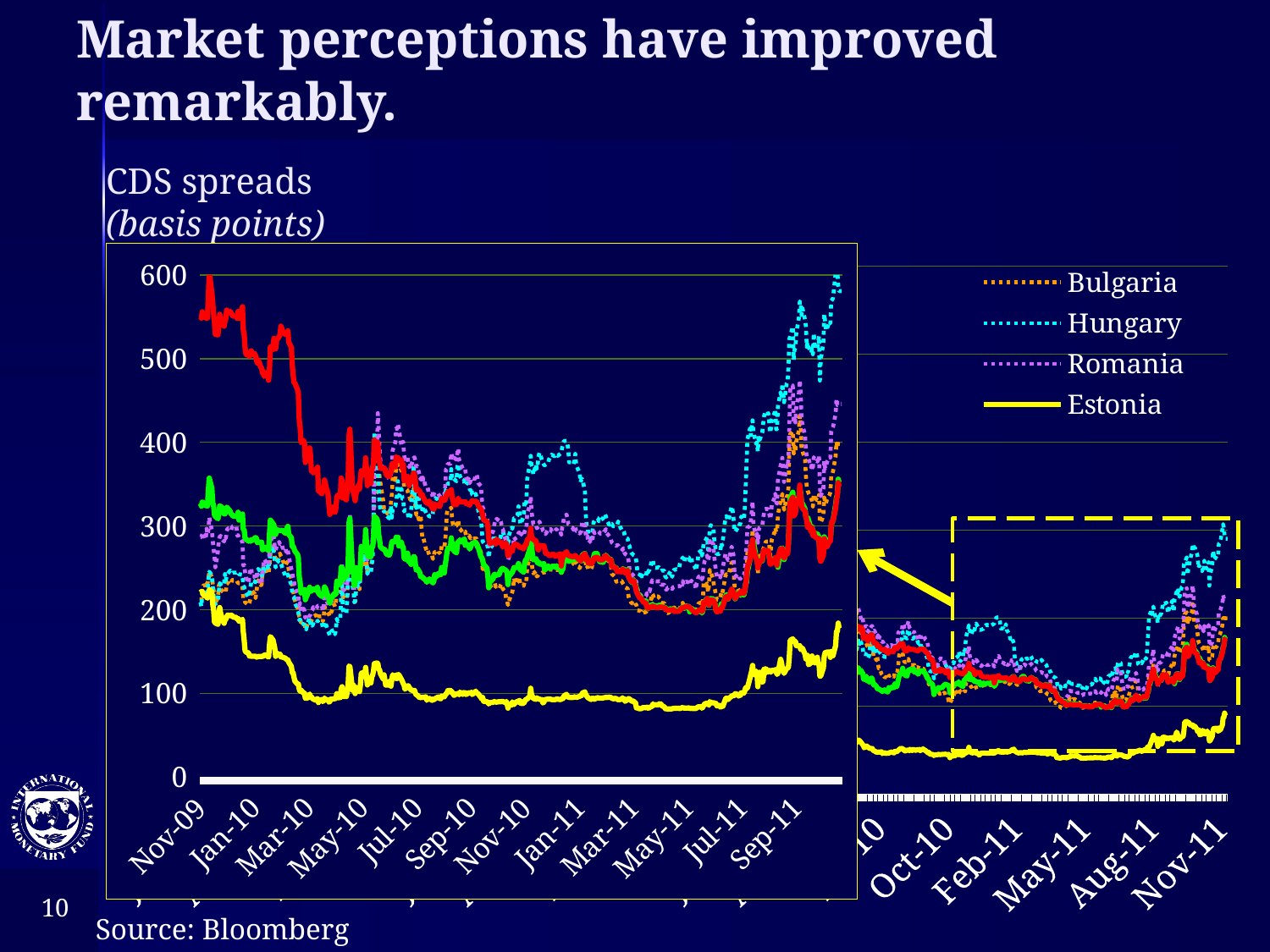
In the inset (zoomed) CDS spreads chart, which is larger at Sep-11: Hungary or Estonia? Hungary In the inset (zoomed) CDS spreads chart, which series has the lowest values throughout the period? Estonia What kind of chart is used to show the CDS spreads? Line chart In the inset (zoomed) CDS spreads chart, is the value for Estonia at the end of the period (Sep-11) greater or less than 200? less In what units are the CDS spreads shown on the chart? Basis points How many series does the legend of the CDS spreads chart list? 4 What is the source cited for the CDS spreads chart? Bloomberg In the inset (zoomed) CDS spreads chart, is the value for Hungary at the end of the period (Sep-11) greater or less than 500? greater In the inset (zoomed) CDS spreads chart, is the value for Bulgaria around May-11 greater or less than 300? less In the inset (zoomed) CDS spreads chart, does the Estonia series rise or fall from Nov-09 to May-11? Fall In the inset (zoomed) CDS spreads chart, which series is highest at the end of the period (Sep-11)? Hungary